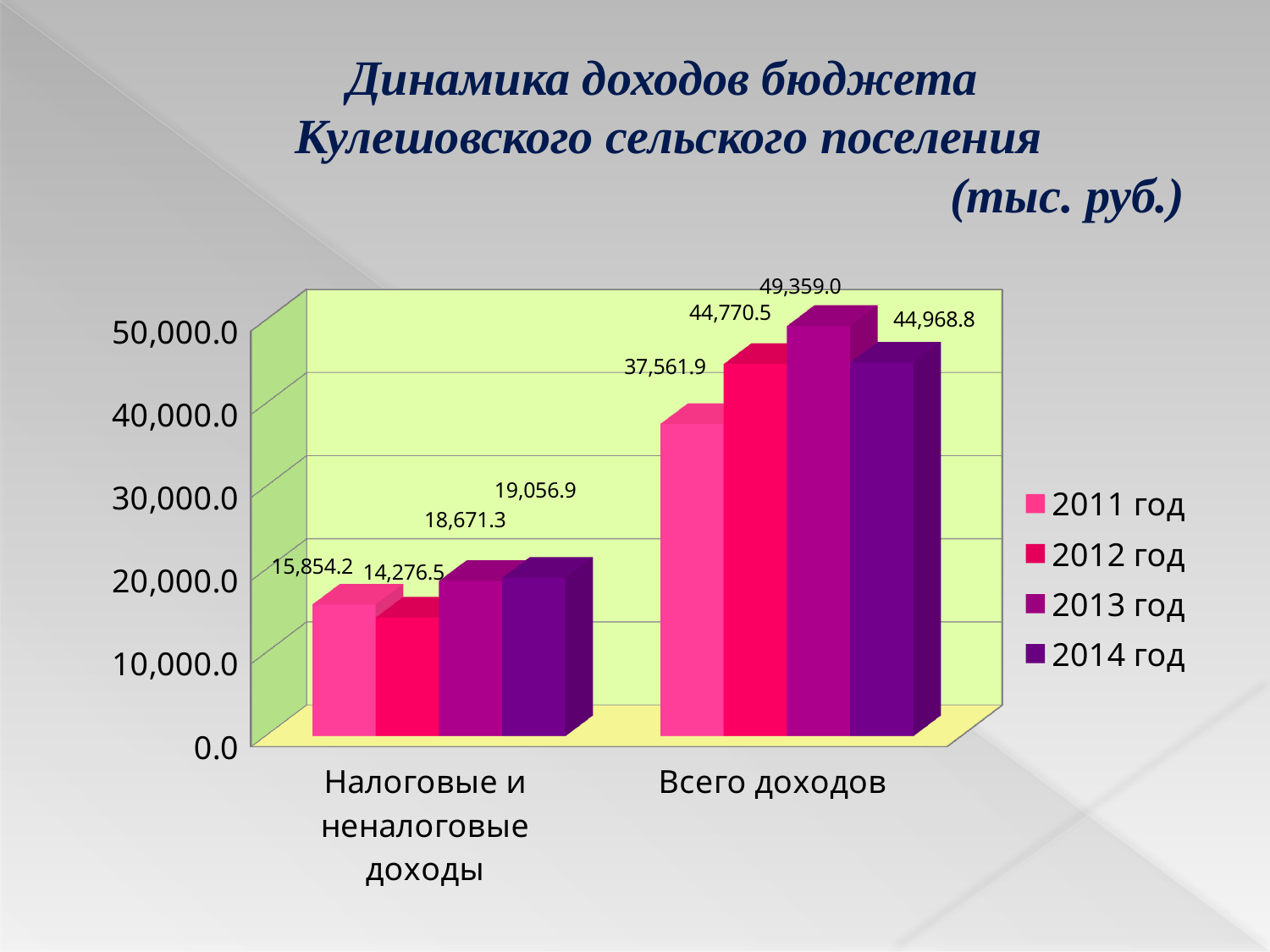
How many series does the legend list? 4 Which is larger in the Всего доходов category: the value for 2012 год or the value for 2014 год? 2014 год What kind of chart is shown on the slide? Bar chart What is the value for 2014 год in the Всего доходов category? 44,968.8 What is the value for 2011 год in the Налоговые и неналоговые доходы category? 15,854.2 What is the value for 2013 год in the Всего доходов category? 49,359.0 Which year has the lowest value in the Налоговые и неналоговые доходы category? 2012 год What is the difference between the 2013 год and 2011 год values in the Всего доходов category? 11,797.1 What is the value for 2012 год in the Налоговые и неналоговые доходы category? 14,276.5 Which year has the highest value in the Всего доходов category? 2013 год What unit is given in the chart title? тыс. руб. How many categories are shown on the x axis? 2